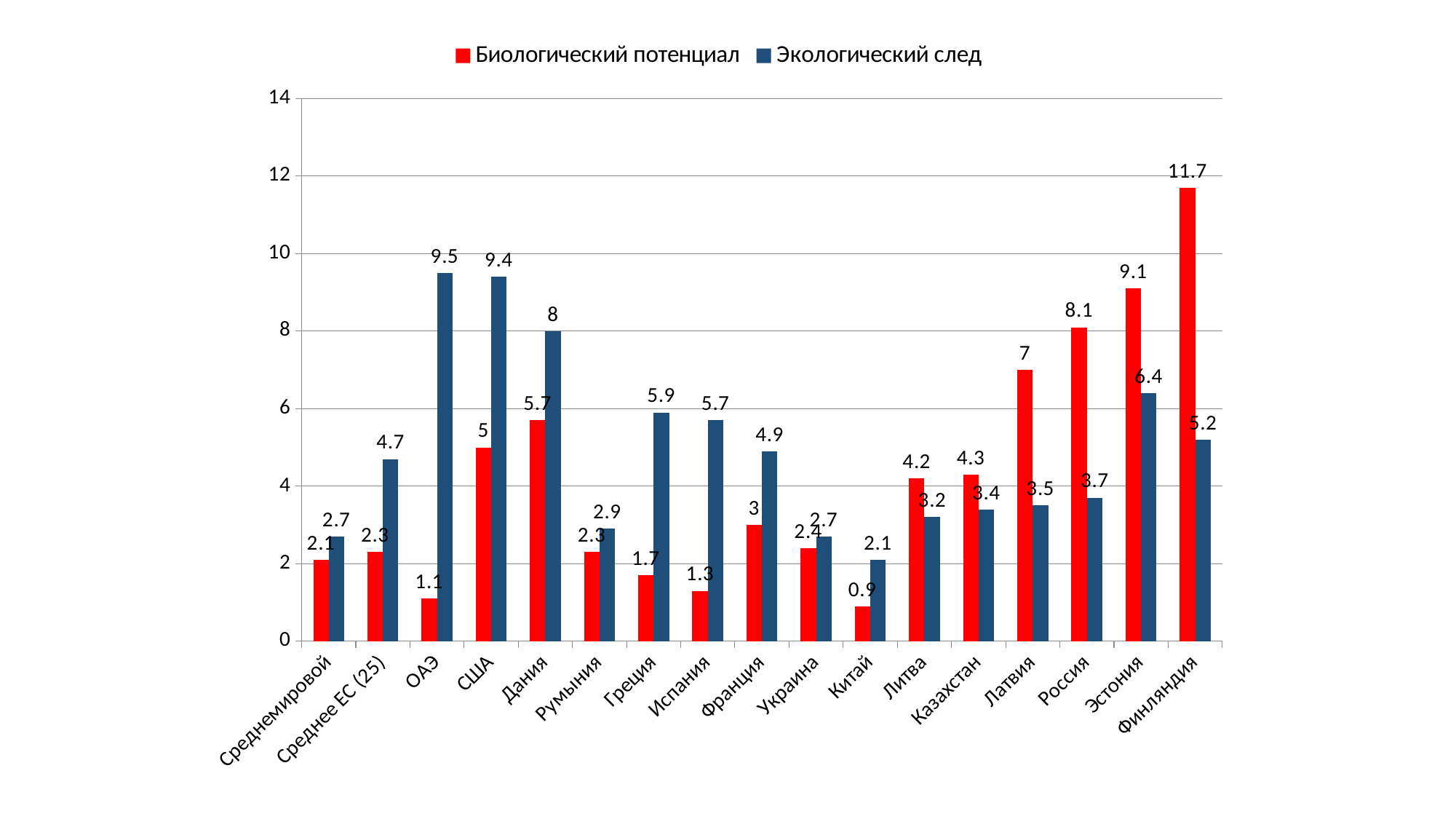
Which is larger for Россия: Биологический потенциал or Экологический след? Биологический потенциал How many series does the legend list? 2 What is the Биологический потенциал value for Финляндия? 11.7 Which category has the lowest Биологический потенциал value? Китай What is the Экологический след value for Дания? 8 Which category has the highest Экологический след value? ОАЭ What is the difference between the Экологический след and Биологический потенциал values for США? 4.4 How many categories are shown on the x axis? 17 What is the Экологический след value for ОАЭ? 9.5 Which category has the highest Биологический потенциал value? Финляндия What kind of chart is shown on the slide? Bar chart What colour are the Биологический потенциал bars? Red